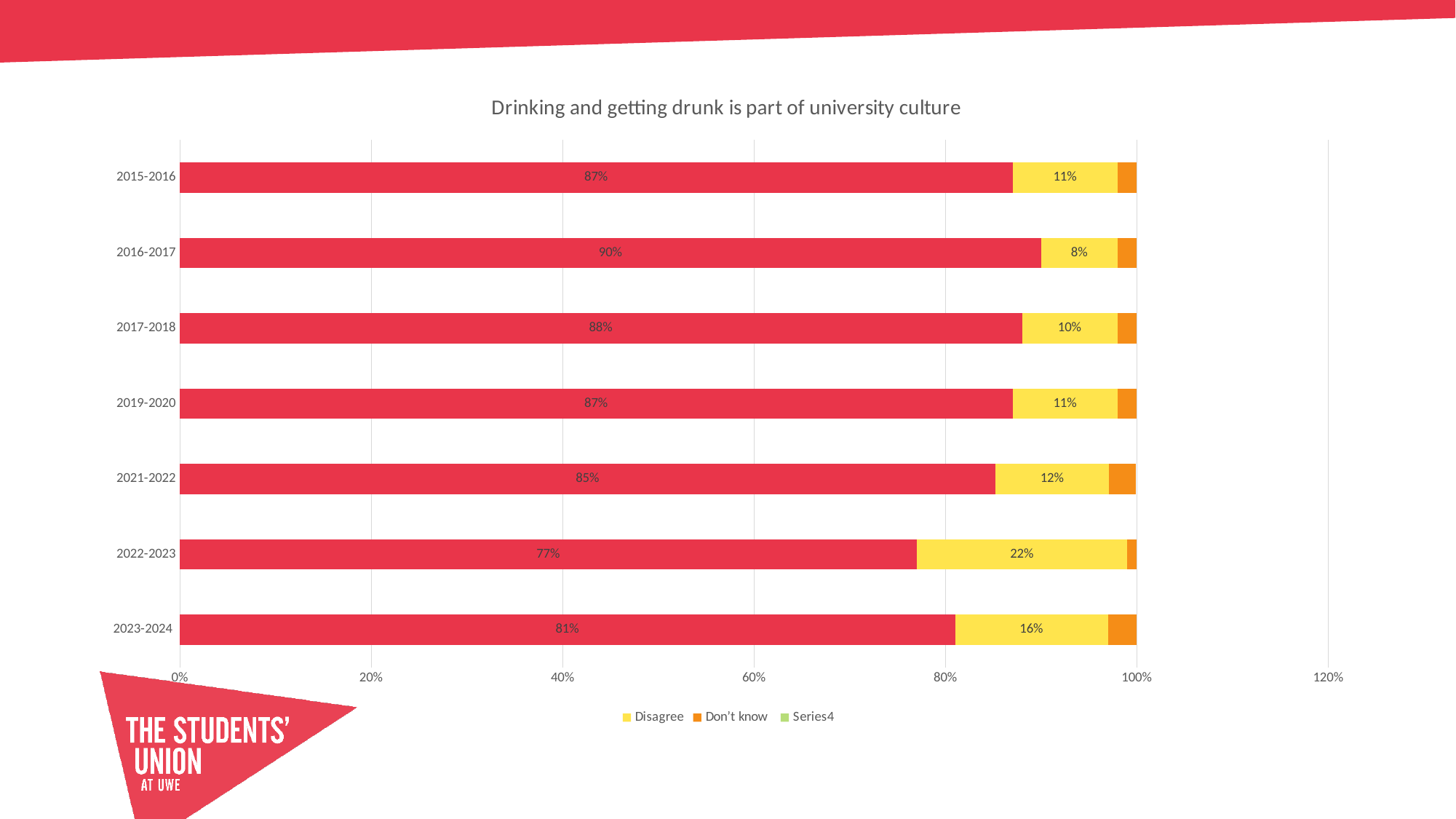
What is the Disagree value for 2016-2017? 8% How many series does the legend list? 3 What is the difference between the Disagree values for 2022-2023 and 2021-2022? 10% Which is larger, the Disagree value for 2023-2024 or for 2019-2020? 2023-2024 What kind of chart is shown on the slide? Stacked bar chart What is the value printed on the red segment for 2022-2023? 77% What is the Disagree value for 2022-2023? 22% Which year has the lowest Disagree value? 2016-2017 What is the title of the chart? Drinking and getting drunk is part of university culture What is the Disagree value for 2023-2024? 16% How many academic years are shown on the chart? 7 Which year has the highest Disagree value? 2022-2023